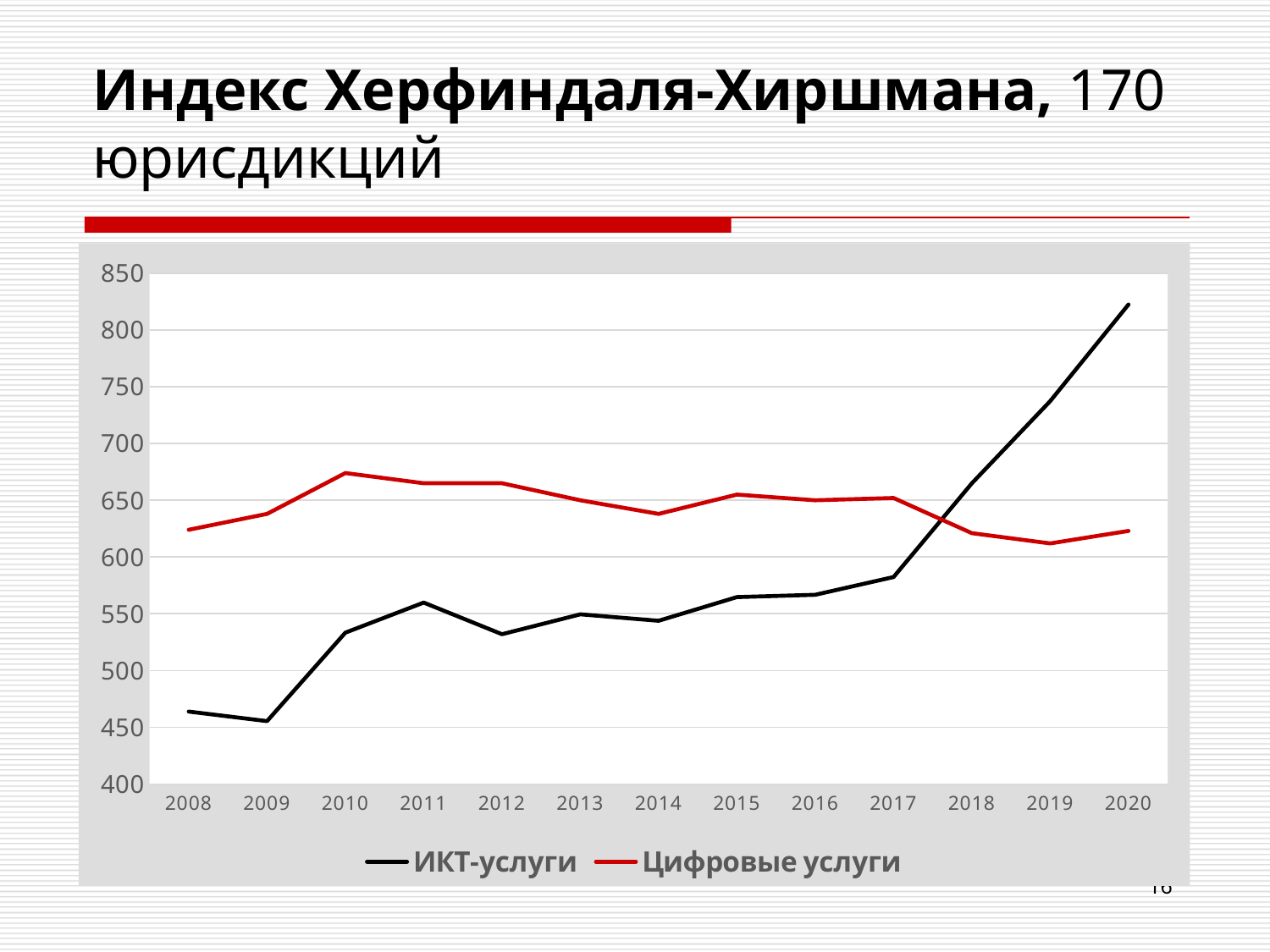
In which year is the value for ИКТ-услуги highest? 2020 What colour is the line for Цифровые услуги? red How many years are shown on the x axis? 13 Does the value for ИКТ-услуги rise or fall from 2017 to 2020? rise Which series has the higher value in 2008, ИКТ-услуги or Цифровые услуги? Цифровые услуги In which year is the value for ИКТ-услуги lowest? 2009 Is the value for ИКТ-услуги in 2008 greater or less than 500? less In which year is the value for Цифровые услуги highest? 2010 What kind of chart is shown on the slide? line chart In which year is the value for Цифровые услуги lowest? 2019 How many series does the legend list? 2 Is the value for ИКТ-услуги in 2020 greater or less than 800? greater